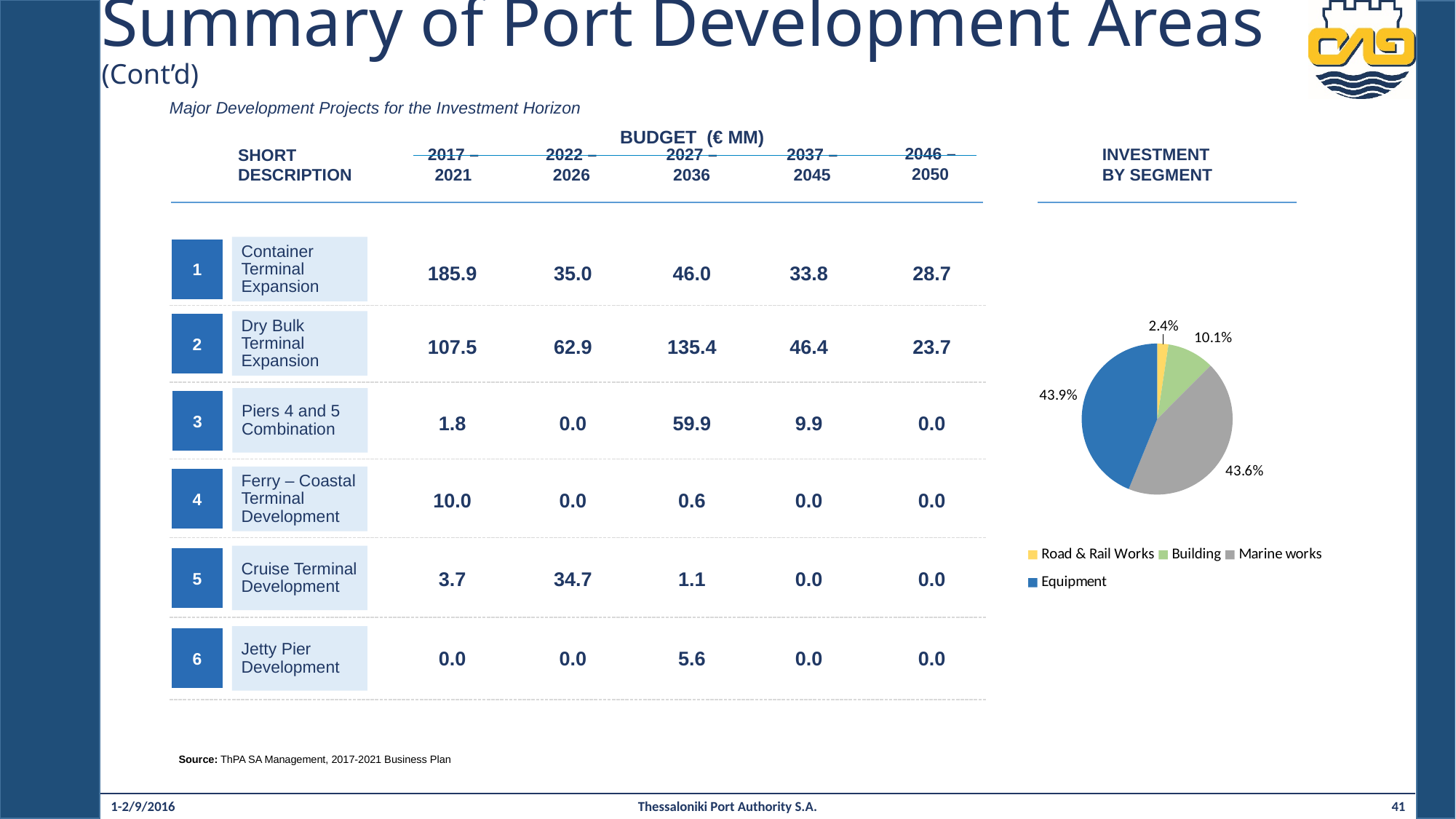
In the "Investment by Segment" pie chart, which slice is larger: Building or Road & Rail Works? Building In the "Investment by Segment" pie chart, what share is labelled for Building? 10.1% How many entries does the legend of the "Investment by Segment" pie chart list? 4 In the "Investment by Segment" pie chart, what share is labelled for Equipment? 43.9% In the "Investment by Segment" pie chart, what is the combined share of Equipment and Marine works? 87.5% In the "Investment by Segment" pie chart, what share is labelled for Road & Rail Works? 2.4% What type of chart is shown under the heading "Investment by Segment"? Pie chart Which segment has the smallest slice in the "Investment by Segment" pie chart? Road & Rail Works How many slices does the "Investment by Segment" pie chart have? 4 In the "Investment by Segment" pie chart, by how many percentage points does Building exceed Road & Rail Works? 7.7 percentage points In the "Investment by Segment" pie chart, what share is labelled for Marine works? 43.6% What colour is the Equipment slice in the "Investment by Segment" pie chart? Blue